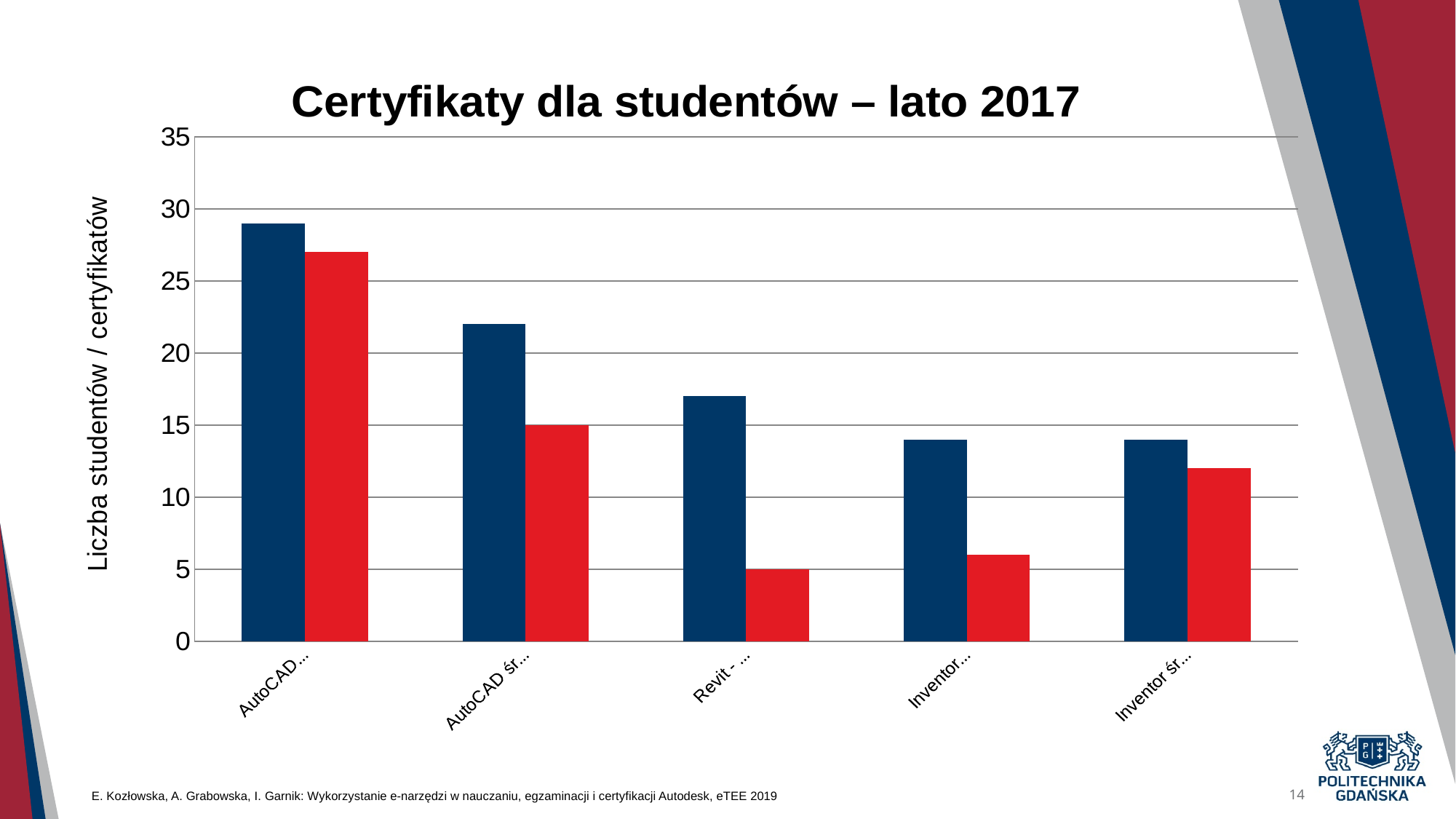
Which category has the tallest dark blue bar? AutoCAD... Which is larger: the dark blue bar for AutoCAD... or the dark blue bar for AutoCAD śr...? AutoCAD... Is the dark blue bar for AutoCAD... greater or less than 25? greater How many categories are shown on the horizontal axis? 5 What is the title of the chart? Certyfikaty dla studentów – lato 2017 Is the dark blue bar for Inventor... greater or less than 15? less Do the dark blue bars generally rise or fall from left to right across the categories? fall Is the red bar for Inventor śr... greater or less than 10? greater What is the label of the vertical axis? Liczba studentów / certyfikatów Which category has the shortest red bar? Revit - ... What type of chart is shown on the slide? bar chart